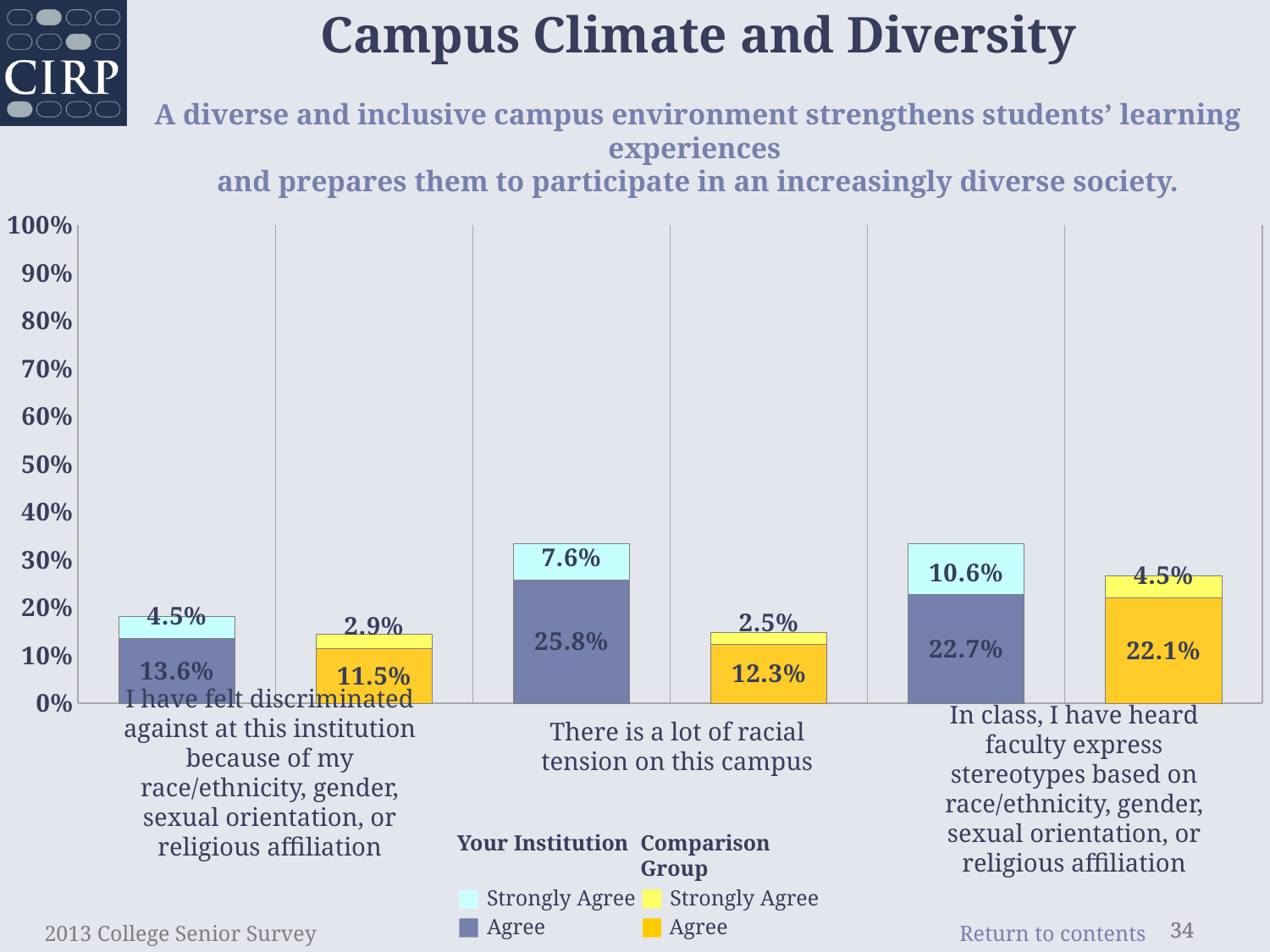
What percentage of the Comparison Group strongly agree that they have felt discriminated against at this institution? 2.9% What is the total percentage (Agree plus Strongly Agree) for Your Institution on 'There is a lot of racial tension on this campus'? 33.4% What is the difference between the Your Institution and Comparison Group 'Agree' values for 'There is a lot of racial tension on this campus'? 13.5% What percentage of students at Your Institution agree that there is a lot of racial tension on this campus? 25.8% What is the total percentage (Agree plus Strongly Agree) for the Comparison Group on 'I have felt discriminated against at this institution'? 14.4% What type of chart is shown on the slide? stacked bar chart Which statement has the lowest 'Strongly Agree' value for the Comparison Group? There is a lot of racial tension on this campus What percentage of the Comparison Group agree that in class they have heard faculty express stereotypes? 22.1% How many entries does the chart legend list? 4 Which statement has the highest 'Strongly Agree' value for Your Institution? In class, I have heard faculty express stereotypes based on race/ethnicity, gender, sexual orientation, or religious affiliation How many statements (categories) are shown on the x axis of the chart? 3 For 'In class, I have heard faculty express stereotypes', is the Your Institution 'Strongly Agree' value larger or smaller than the Comparison Group 'Strongly Agree' value? larger